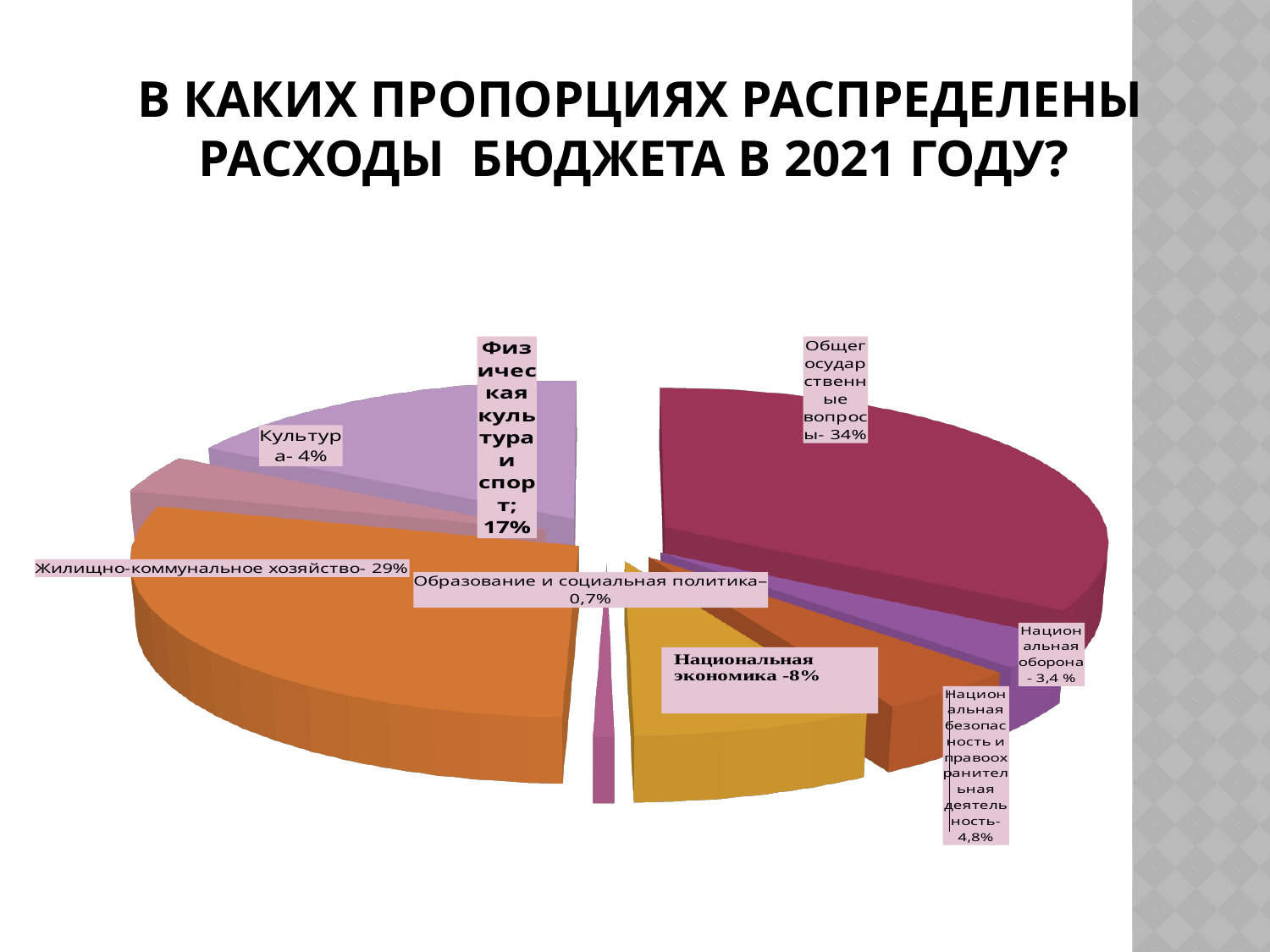
What share is labelled for Физическая культура и спорт? 17% Which category has the largest share of the pie? Общегосударственные вопросы What is the difference in percentage points between Общегосударственные вопросы and Жилищно-коммунальное хозяйство? 5 What share is labelled for Образование и социальная политика? 0,7% Which is larger: the share for Культура or the share for Национальная экономика? Национальная экономика Which category has the smallest share of the pie? Образование и социальная политика What share of the budget expenses goes to Общегосударственные вопросы? 34% What kind of chart is shown on the slide? pie chart How many slices does the pie chart have? 8 What share of the budget expenses goes to Жилищно-коммунальное хозяйство? 29% What share is labelled for Национальная экономика? 8% What share is labelled for Национальная оборона? 3,4 %